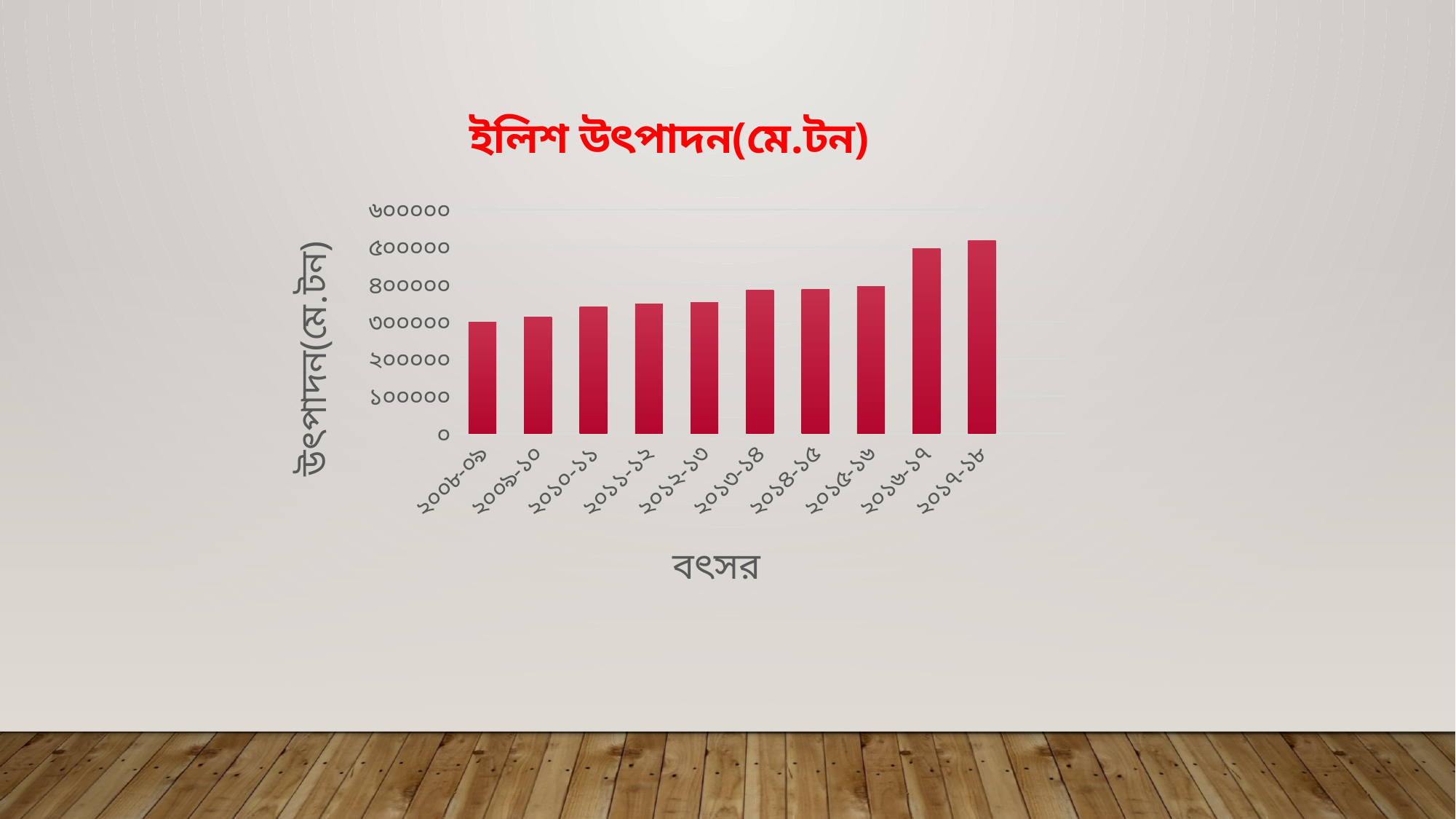
Is the value for ২০১৭-১৮ greater or less than ৪০০০০০? greater What is the title of the chart? ইলিশ উৎপাদন(মে.টন) What kind of chart is shown on the slide? bar chart Is the value for ২০১২-১৩ greater or less than ৩০০০০০? greater Is the value for ২০১০-১১ greater or less than ৪০০০০০? less What is the label on the x axis of the chart? বৎসর Which is larger, the value for ২০১৬-১৭ or the value for ২০১৩-১৪? ২০১৬-১৭ Which year has the highest production? ২০১৭-১৮ Which year has the lowest production? ২০০৮-০৯ Do the values generally rise or fall from ২০০৮-০৯ to ২০১৭-১৮? rise How many years (bars) are plotted on the chart? 10